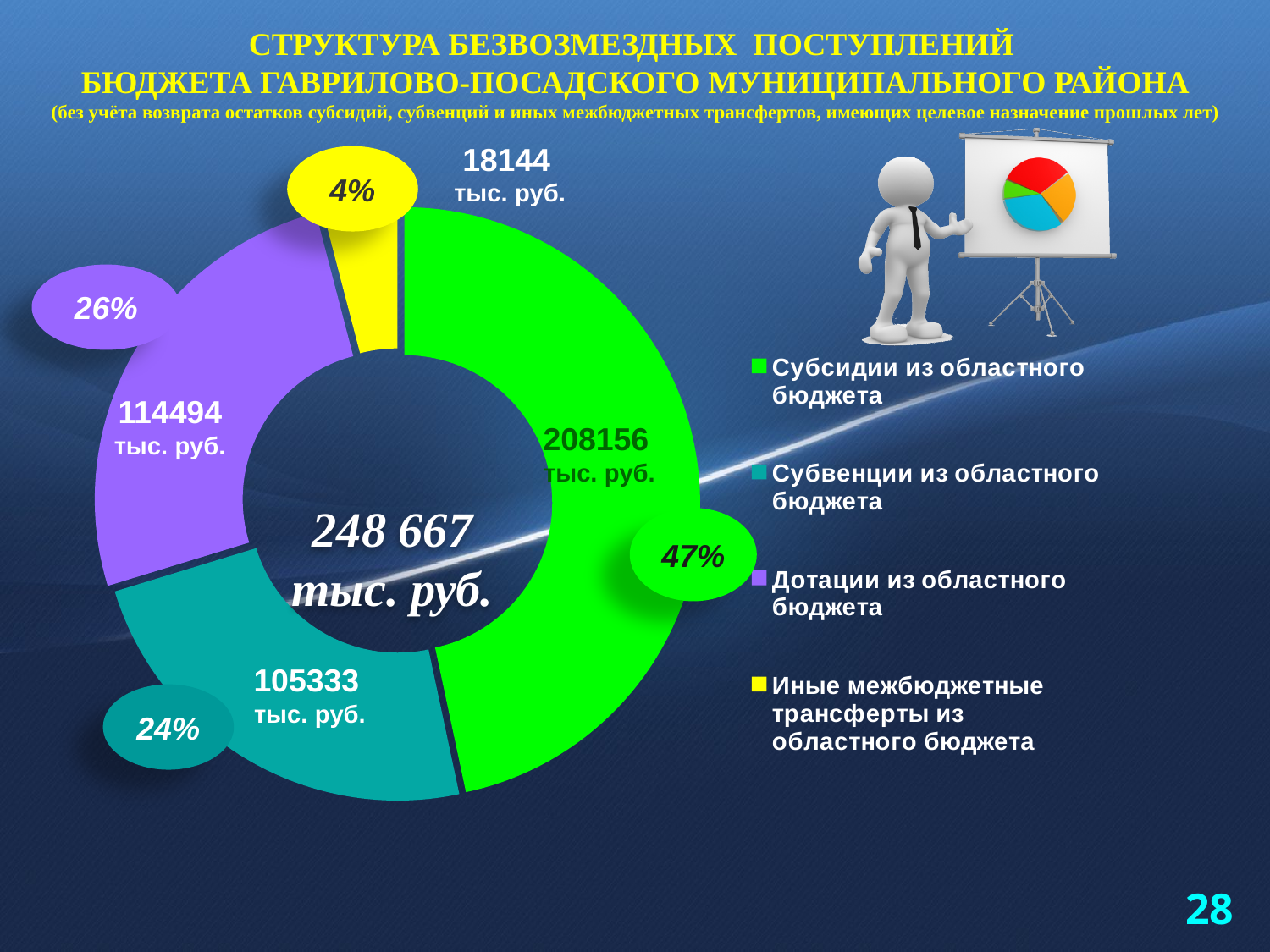
Which category has the largest share of the pie? Субсидии из областного бюджета How many categories does the legend list? 4 What is the difference between the values for "Субсидии из областного бюджета" and "Субвенции из областного бюджета"? 102823 тыс. руб. Which is larger: the value for "Дотации из областного бюджета" or for "Субвенции из областного бюджета"? Дотации из областного бюджета What is the value for "Иные межбюджетные трансферты из областного бюджета"? 18144 тыс. руб. What is the value for "Субвенции из областного бюджета"? 105333 тыс. руб. What share of the pie does "Субсидии из областного бюджета" take? 47% What is the value for "Дотации из областного бюджета"? 114494 тыс. руб. What kind of chart is shown on the slide? Pie (doughnut) chart Which category has the smallest share of the pie? Иные межбюджетные трансферты из областного бюджета What share of the pie does "Иные межбюджетные трансферты из областного бюджета" take? 4% What is the value for "Субсидии из областного бюджета"? 208156 тыс. руб.